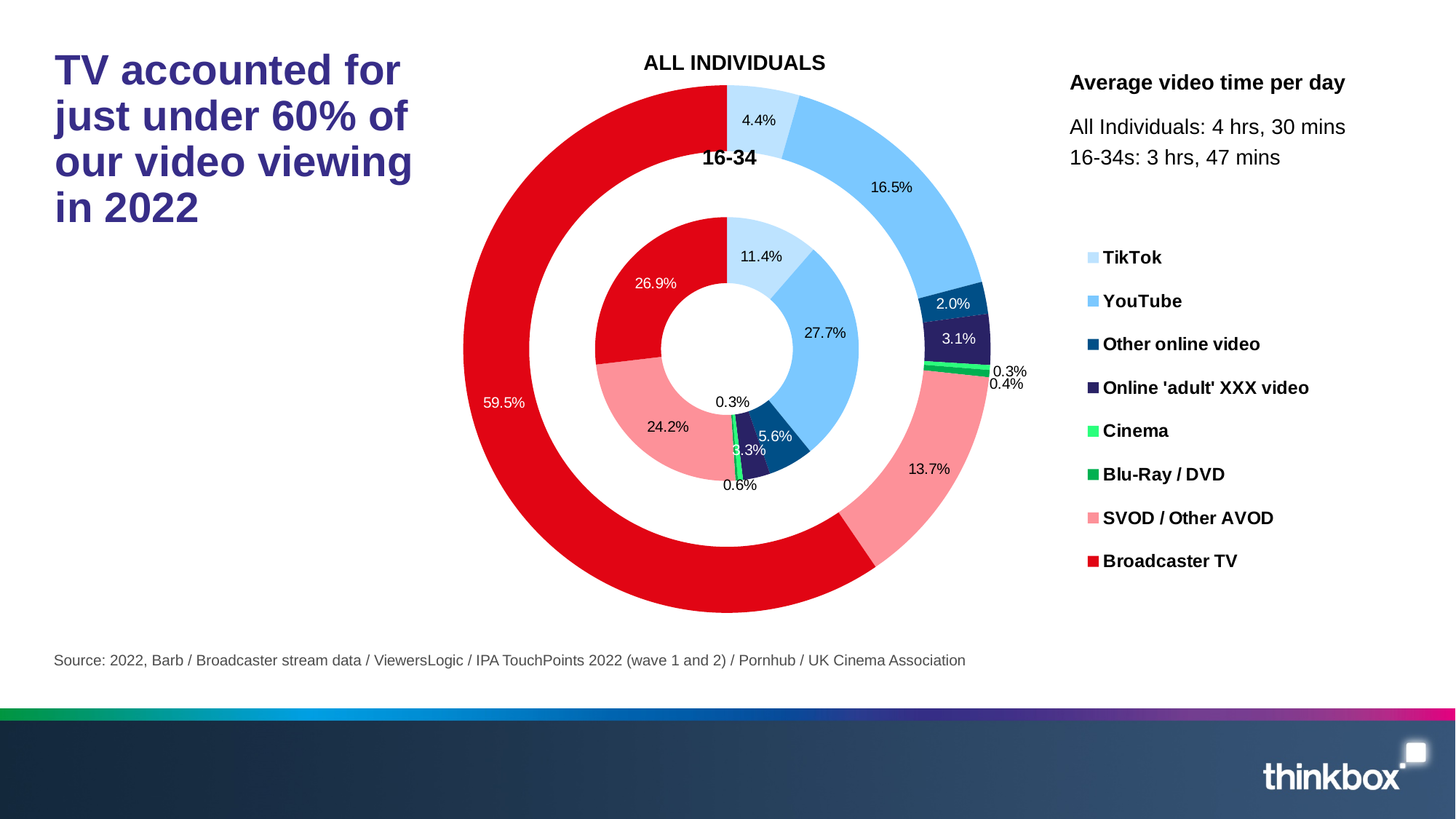
What is the average video time per day for 16-34s according to the slide? 3 hrs, 47 mins What share of video viewing did Broadcaster TV account for among All Individuals? 59.5% How many categories does the legend list? 8 What share of video viewing did TikTok account for among All Individuals? 4.4% Which is larger for 16-34s: the TikTok share or the Other online video share? TikTok What share of video viewing did YouTube account for among 16-34s? 27.7% What type of chart is shown on the slide? Doughnut chart How many rings (series) does the doughnut chart have? 2 What share of video viewing did SVOD / Other AVOD account for among 16-34s? 24.2% What is the difference between the Broadcaster TV share for All Individuals and for 16-34s? 32.6 percentage points Which category has the largest share in the 16-34 ring? YouTube Which category has the largest share in the All Individuals ring? Broadcaster TV